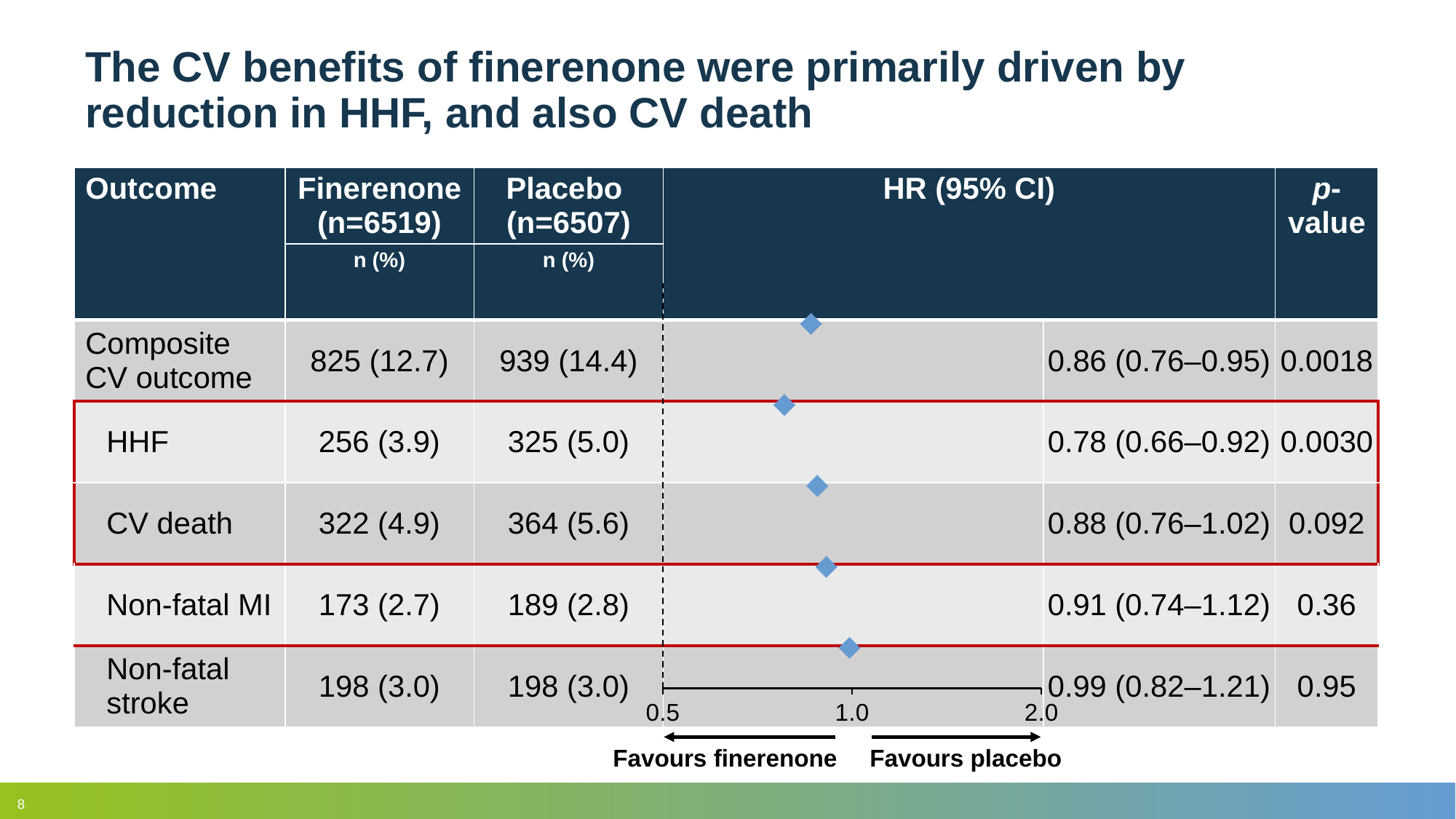
Which outcome has the highest hazard ratio in the forest plot? Non-fatal stroke What is the hazard ratio (95% CI) plotted for HHF? 0.78 (0.66–0.92) What is the hazard ratio plotted for the composite CV outcome? 0.86 Which outcome has the lowest hazard ratio in the forest plot? HHF Which has the larger hazard ratio, HHF or Non-fatal MI? Non-fatal MI What is the hazard ratio plotted for CV death? 0.88 How many outcomes are plotted in the forest plot? 5 What kind of chart is shown in the HR (95% CI) column? Forest plot What is the difference between the hazard ratios for Non-fatal stroke and HHF? 0.21 Is the hazard ratio for HHF greater or less than 1.0? less What does the left side of the hazard ratio axis favour, according to the label below the chart? Favours finerenone What tick values are shown on the hazard ratio axis? 0.5, 1.0, 2.0